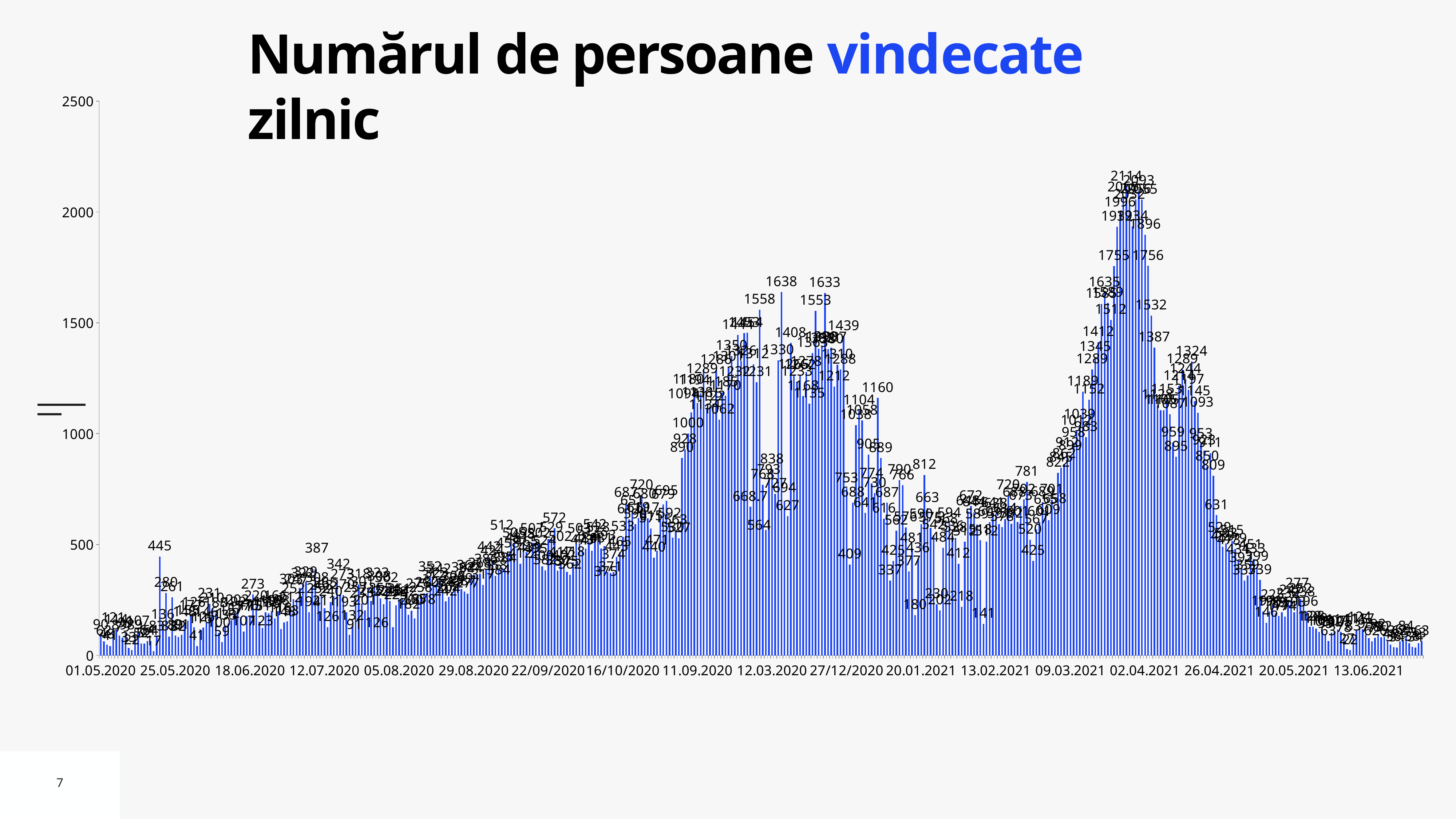
What is the difference between the overall peak value (2114) and the peak value of the late-2020 wave (1638)? 476 What is the title of the chart? Numărul de persoane vindecate zilnic Is the value for the first bar at 01.05.2020 greater or less than 500? less What kind of chart is shown on the slide? bar chart What is the value of the tallest bar between 01.05.2020 and 18.06.2020? 445 Do the values generally rise or fall between 09.03.2021 and 02.04.2021? rise What is the value of the tallest bar between 11.09.2020 and 27/12/2020? 1638 Is the tallest bar on the chart greater or less than 2000? greater Do the values generally rise or fall between 02.04.2021 and 13.06.2021? fall Which peak is higher: the one near 02.04.2021 or the one near 12.03.2020? the one near 02.04.2021 What is the highest value labelled on the chart? 2114